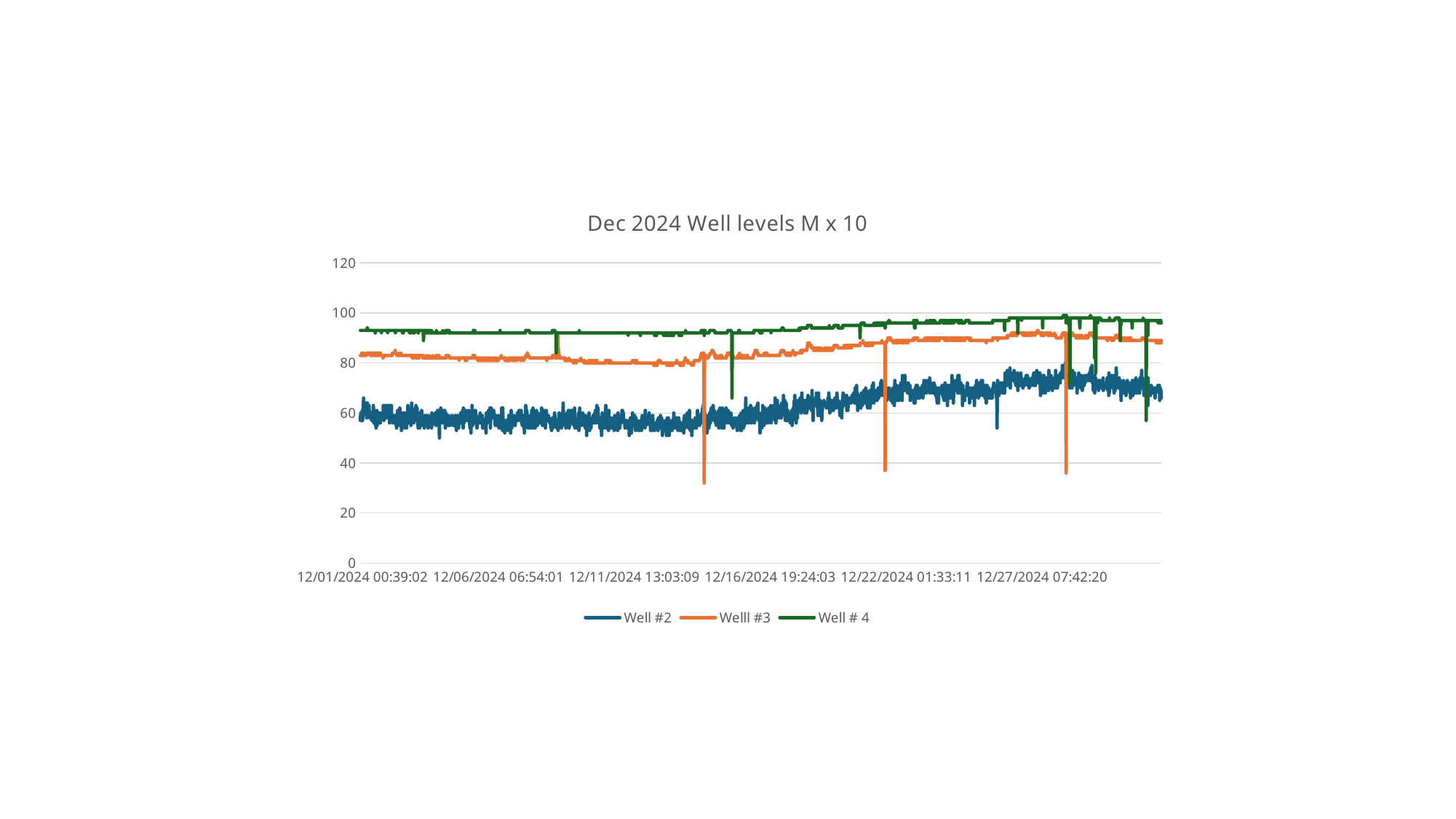
Which series has the lowest values across the chart? Well #2 How many series does the legend list? 3 Which series has the highest values across the chart? Well # 4 Which series is plotted in green? Well # 4 What kind of chart is shown on the slide? line chart Does the Well #2 series generally rise or fall from the start to the end of December? rise Is the value for Well # 4 at 12/27/2024 07:42:20 greater or less than 80? greater Is the value for Well #2 at 12/27/2024 07:42:20 greater or less than 40? greater At 12/06/2024 06:54:01, which is larger, the value for Well # 4 or the value for Well #2? Well # 4 What is the title of the chart? Dec 2024 Well levels M x 10 Is the value for Well #2 at 12/01/2024 00:39:02 greater or less than 80? less